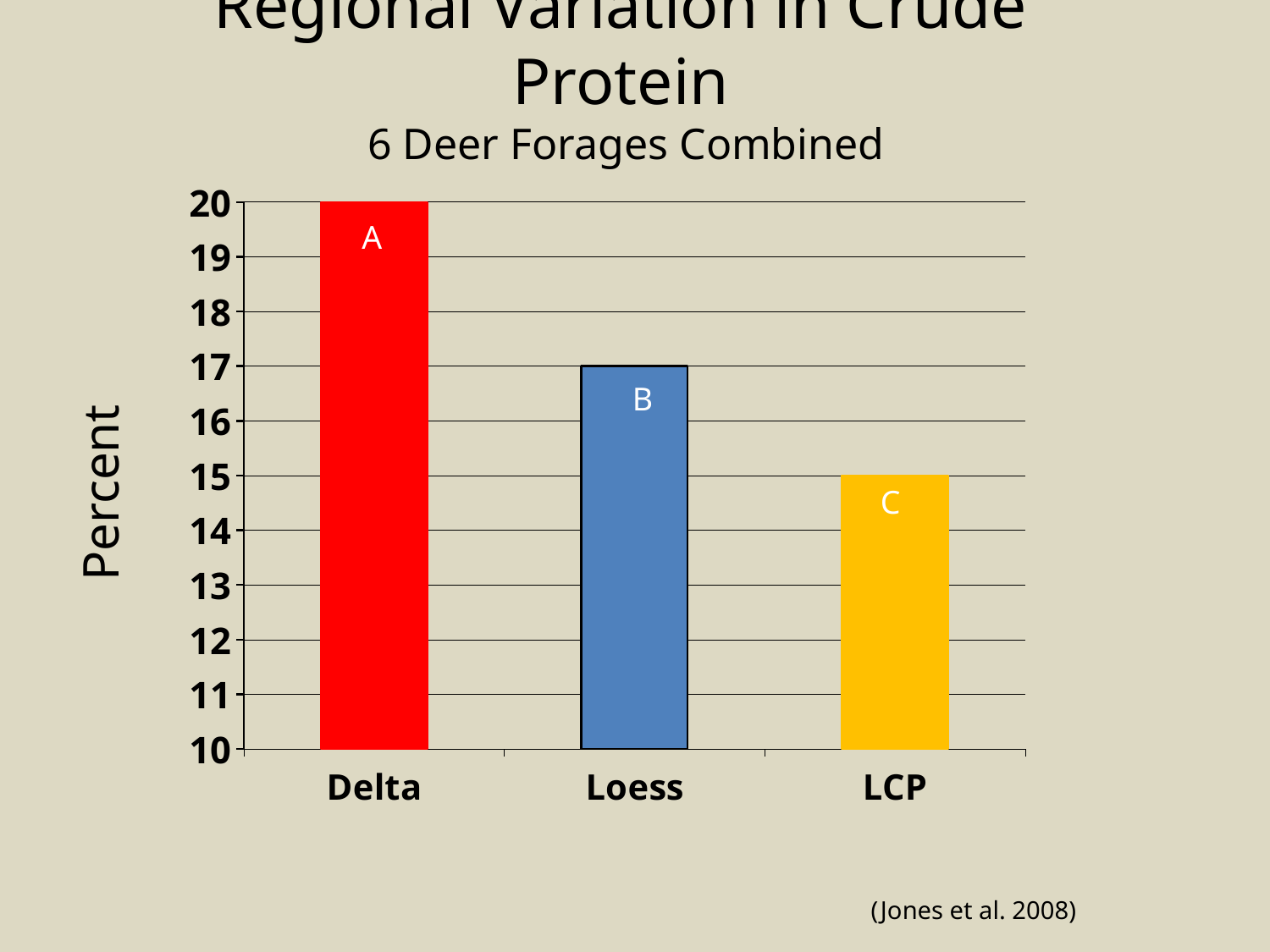
Which is larger, the value for Loess or the value for LCP? Loess Which region has the lowest crude protein value? LCP What kind of chart is shown on the slide? bar chart What is the difference between the values for Delta and LCP? 5 How many regions are shown on the chart? 3 What is the value for Loess? 17 Is the value for Loess greater or less than 16? greater What is the value for LCP? 15 What is the difference between the values for Loess and LCP? 2 What is the value for Delta? 20 Which region has the highest crude protein value? Delta What letter is printed inside the bar for Loess? B